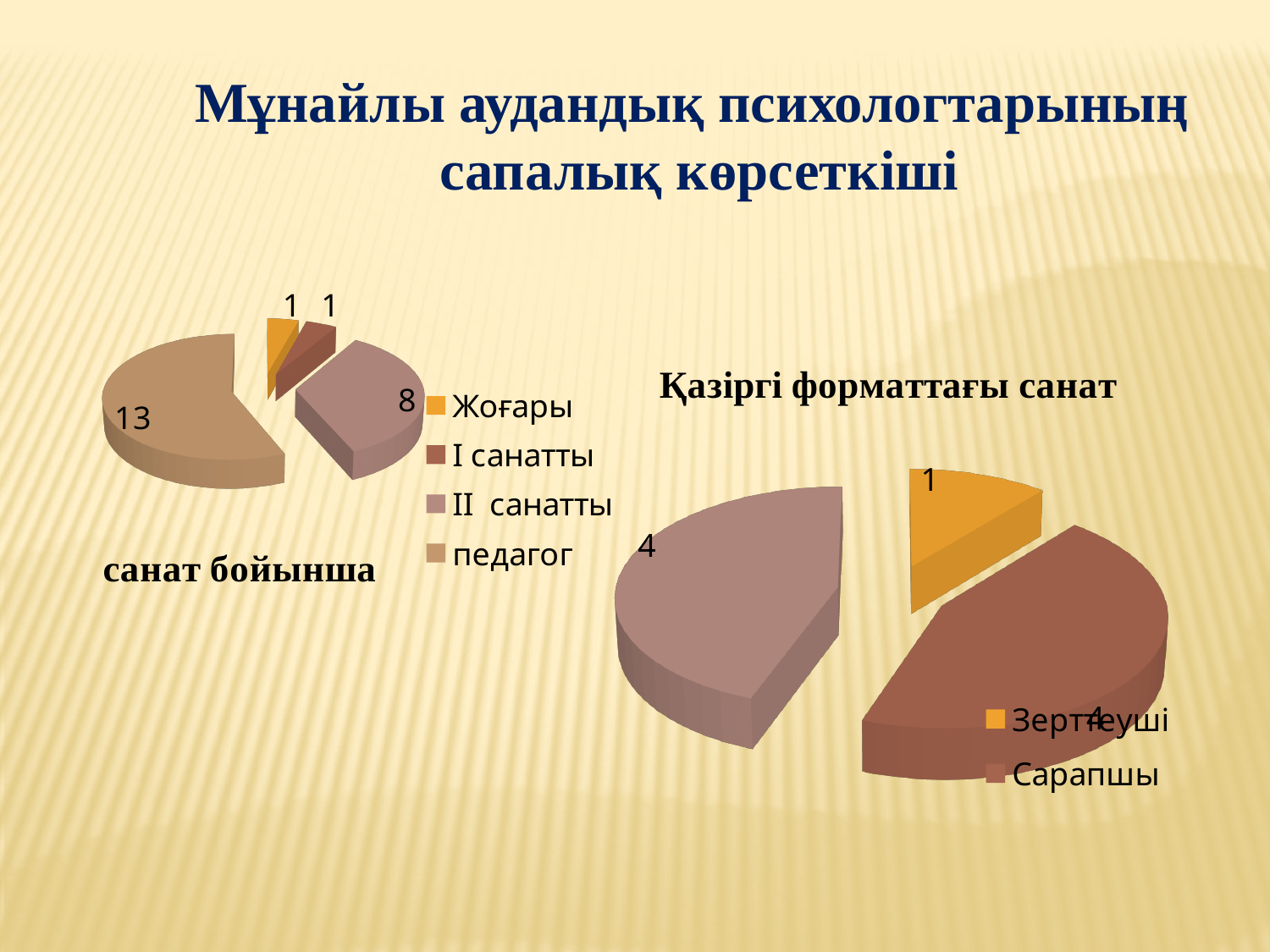
In the "санат бойынша" chart, what is the value for II санатты? 8 What kind of chart is the "санат бойынша" chart on the left of the slide? pie chart What is the title of the chart on the right of the slide? Қазіргі форматтағы санат In the "санат бойынша" chart, what is the value for педагог? 13 In the "Қазіргі форматтағы санат" chart, which is larger, Сарапшы or Зерттеуші? Сарапшы In the "Қазіргі форматтағы санат" chart, what is the value for Сарапшы? 4 In the "санат бойынша" chart, what is the total of all the slice values? 23 In the "Қазіргі форматтағы санат" chart, what is the value for Зерттеуші? 1 In the "санат бойынша" chart, what is the difference between the values for педагог and II санатты? 5 How many entries does the legend of the "санат бойынша" chart list? 4 In the "санат бойынша" chart, which category has the largest slice? педагог In the "санат бойынша" chart, what is the value for Жоғары? 1